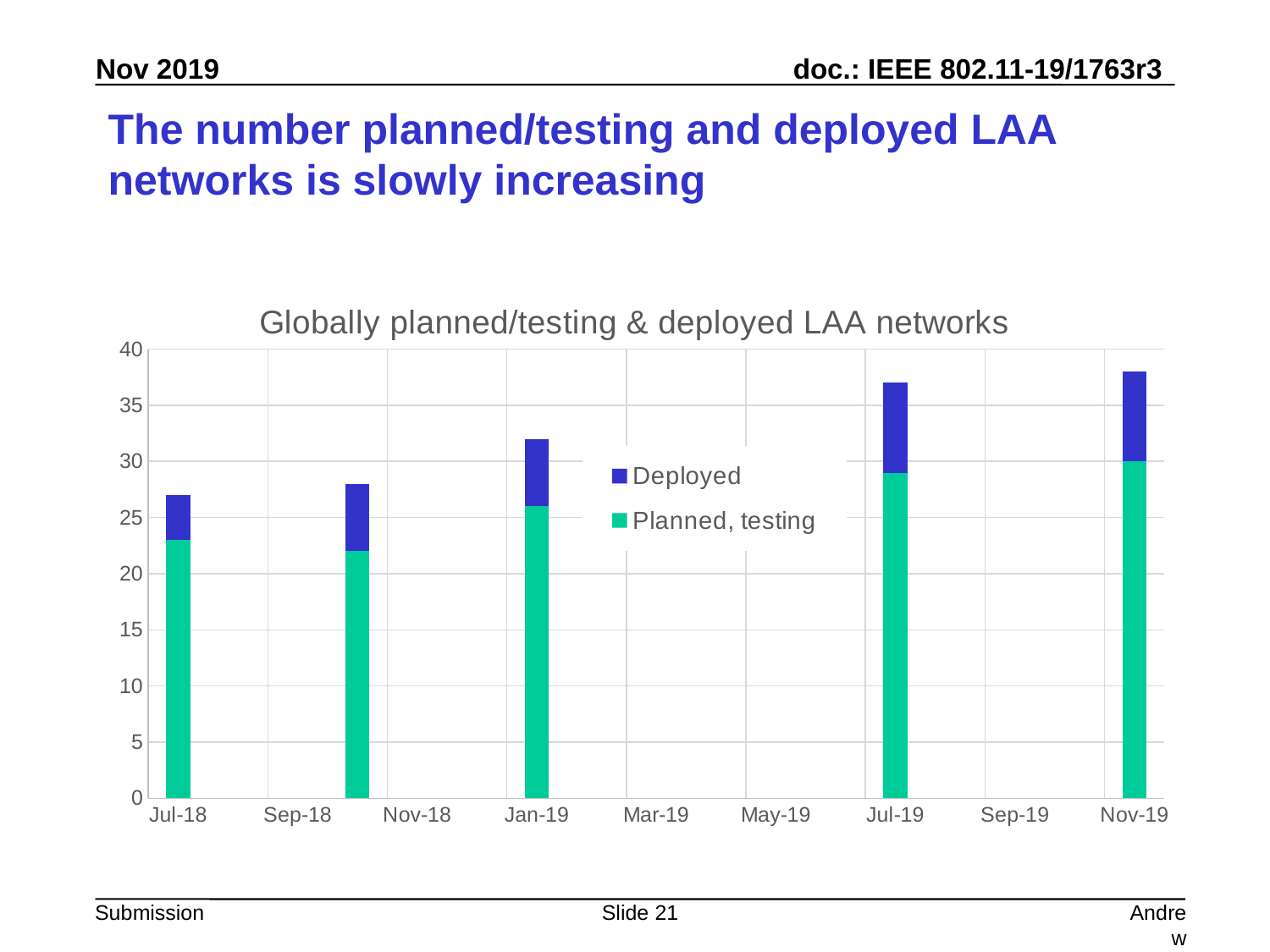
Which bar has the larger total, Jan-19 or Jul-19? Jul-19 Is the total height of the Jul-19 bar greater or less than 35? greater Is the total height of the Jul-18 bar greater or less than 30? less Is the Planned, testing value for Jul-18 greater or less than 25? less What is the title of the chart? Globally planned/testing & deployed LAA networks Do the total bar heights rise or fall from Jul-18 to Nov-19? Rise How many series does the chart legend list? 2 How many stacked bars are plotted in the chart? 5 Which series is shown in green in the chart? Planned, testing What kind of chart is shown on the slide? Bar chart